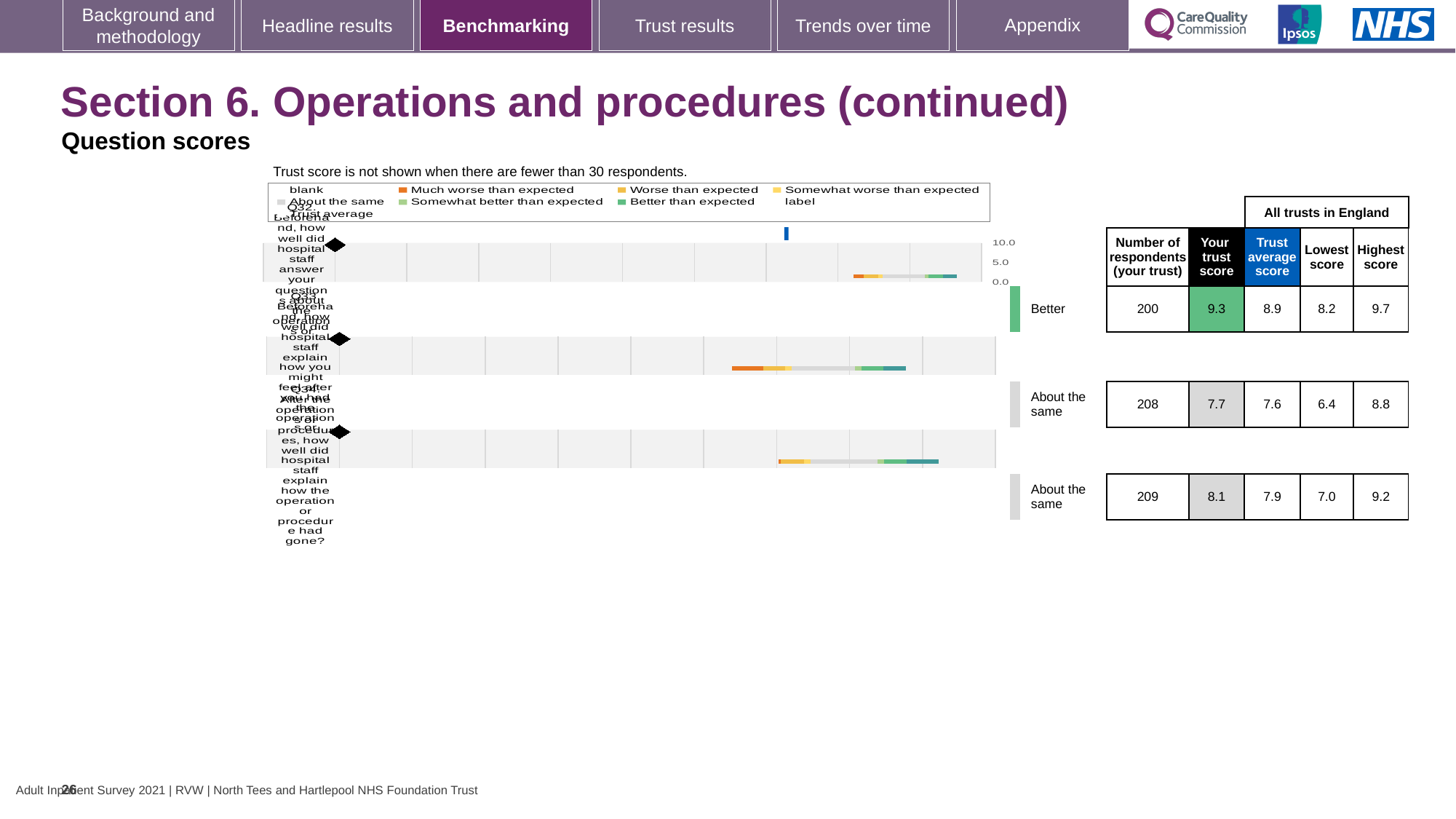
For the third question row, what is the difference between the 'Highest score' and the 'Lowest score'? 2.2 For the second question row, which is larger: 'Your trust score' or 'Trust average score'? Your trust score (7.7) In the table, what is the 'Your trust score' for the first question row? 9.3 In the table, what is the 'Trust average score' for the third question row? 7.9 In the table, what is the 'Highest score' for the third question row? 9.2 Which question row has the lowest 'Lowest score' in the table? The second row (6.4) For the first question row, what is the difference between 'Your trust score' and 'Trust average score'? 0.4 In the table, how many respondents are shown for the second question row? 208 How many question rows are plotted in the benchmarking chart? 3 What rating label is shown next to the first question row? Better What kind of chart is used to show the question scores? Bar chart Which question row has the highest 'Your trust score' in the table? The first row (9.3)